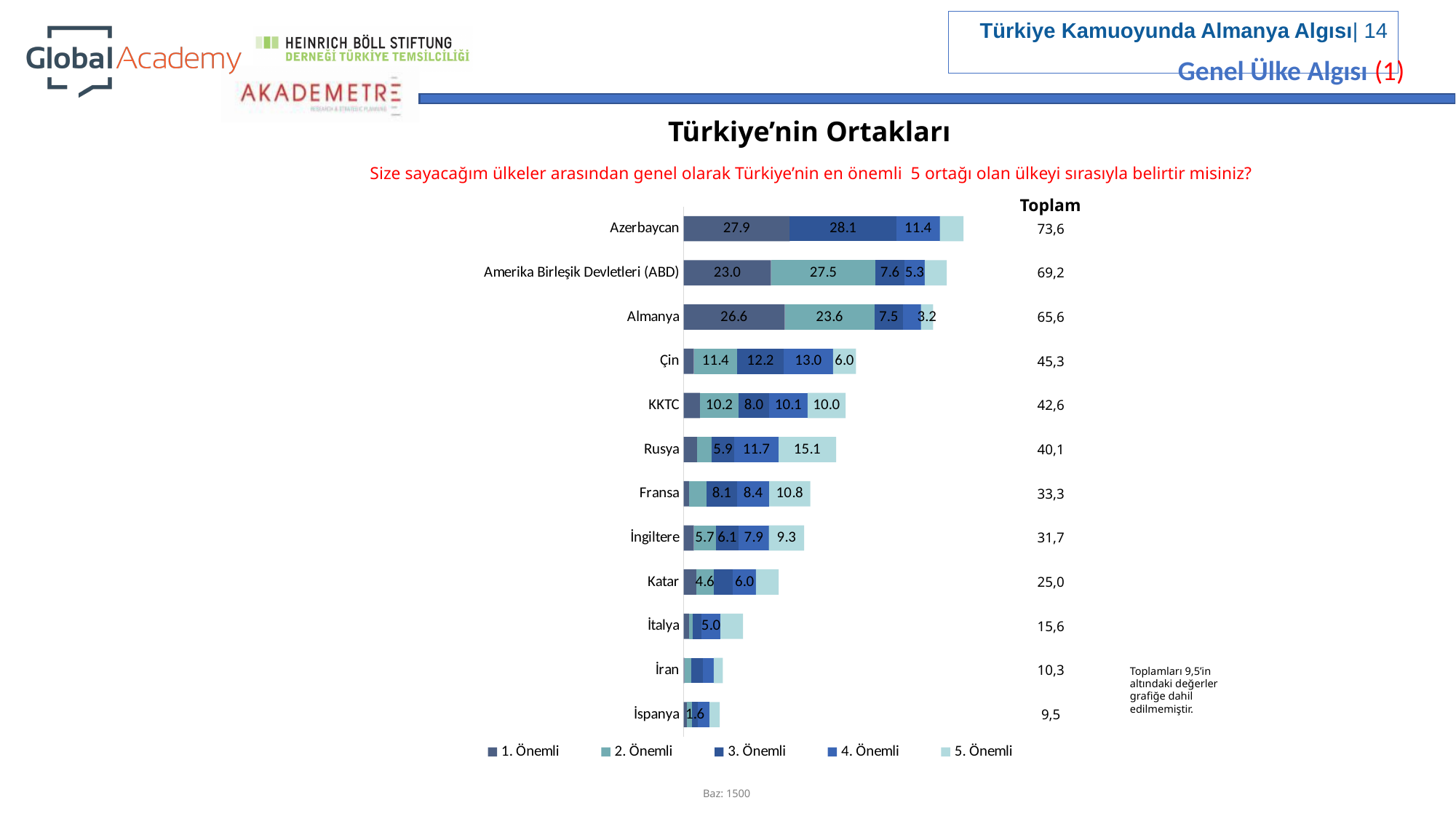
Which country has the lowest Toplam value? İspanya What is the 5. Önemli value for Rusya? 15.1 What is the 1. Önemli value for Amerika Birleşik Devletleri (ABD)? 23.0 What is the Toplam value for Almanya? 65,6 What kind of chart is shown on the slide? Stacked bar chart What is the difference between the Toplam values of Azerbaycan and Amerika Birleşik Devletleri (ABD)? 4,4 How many series does the legend list? 5 Which country has the highest Toplam value? Azerbaycan What is the title of the chart? Türkiye'nin Ortakları What is the 1. Önemli value for Azerbaycan? 27.9 How many countries are listed in the chart? 12 Which has a larger Toplam value, Çin or KKTC? Çin